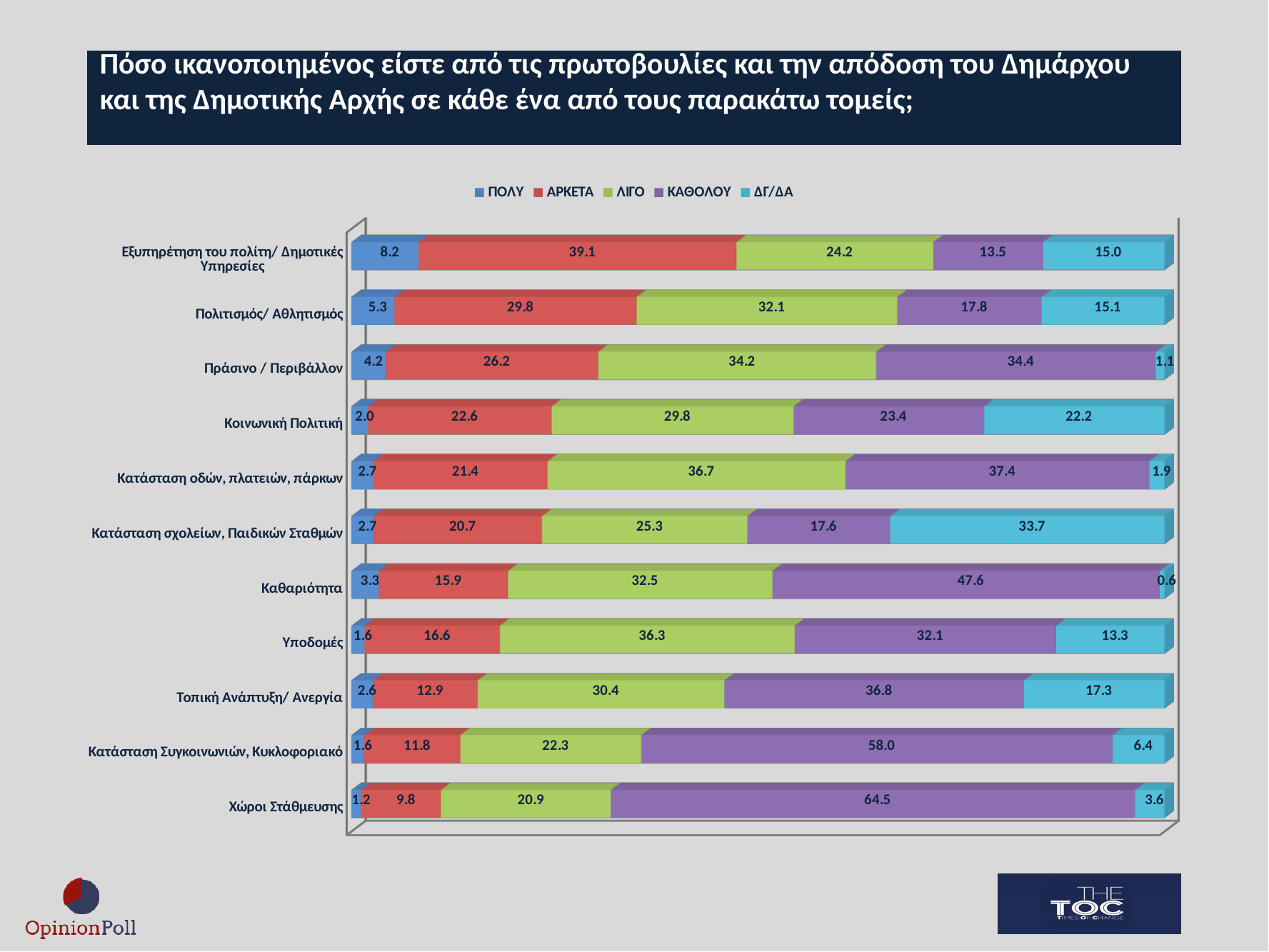
What type of chart is shown on the slide? Stacked bar chart Which category has the highest ΠΟΛΥ value? Εξυπηρέτηση του πολίτη/ Δημοτικές Υπηρεσίες What is the difference between the ΚΑΘΟΛΟΥ values for Χώροι Στάθμευσης and Κατάσταση Συγκοινωνιών, Κυκλοφοριακό? 6.5 What is the total of the stacked bar for Χώροι Στάθμευσης? 100.0 How many series does the legend list? 5 What is the ΚΑΘΟΛΟΥ value for Καθαριότητα? 47.6 Which category has the highest ΚΑΘΟΛΟΥ value? Χώροι Στάθμευσης What is the ΔΓ/ΔΑ value for Κατάσταση σχολείων, Παιδικών Σταθμών? 33.7 Which category has the lowest ΑΡΚΕΤΑ value? Χώροι Στάθμευσης Which has the larger ΑΡΚΕΤΑ value, Πολιτισμός/ Αθλητισμός or Πράσινο / Περιβάλλον? Πολιτισμός/ Αθλητισμός How many categories are plotted on the chart? 11 What is the ΑΡΚΕΤΑ value for Εξυπηρέτηση του πολίτη/ Δημοτικές Υπηρεσίες? 39.1